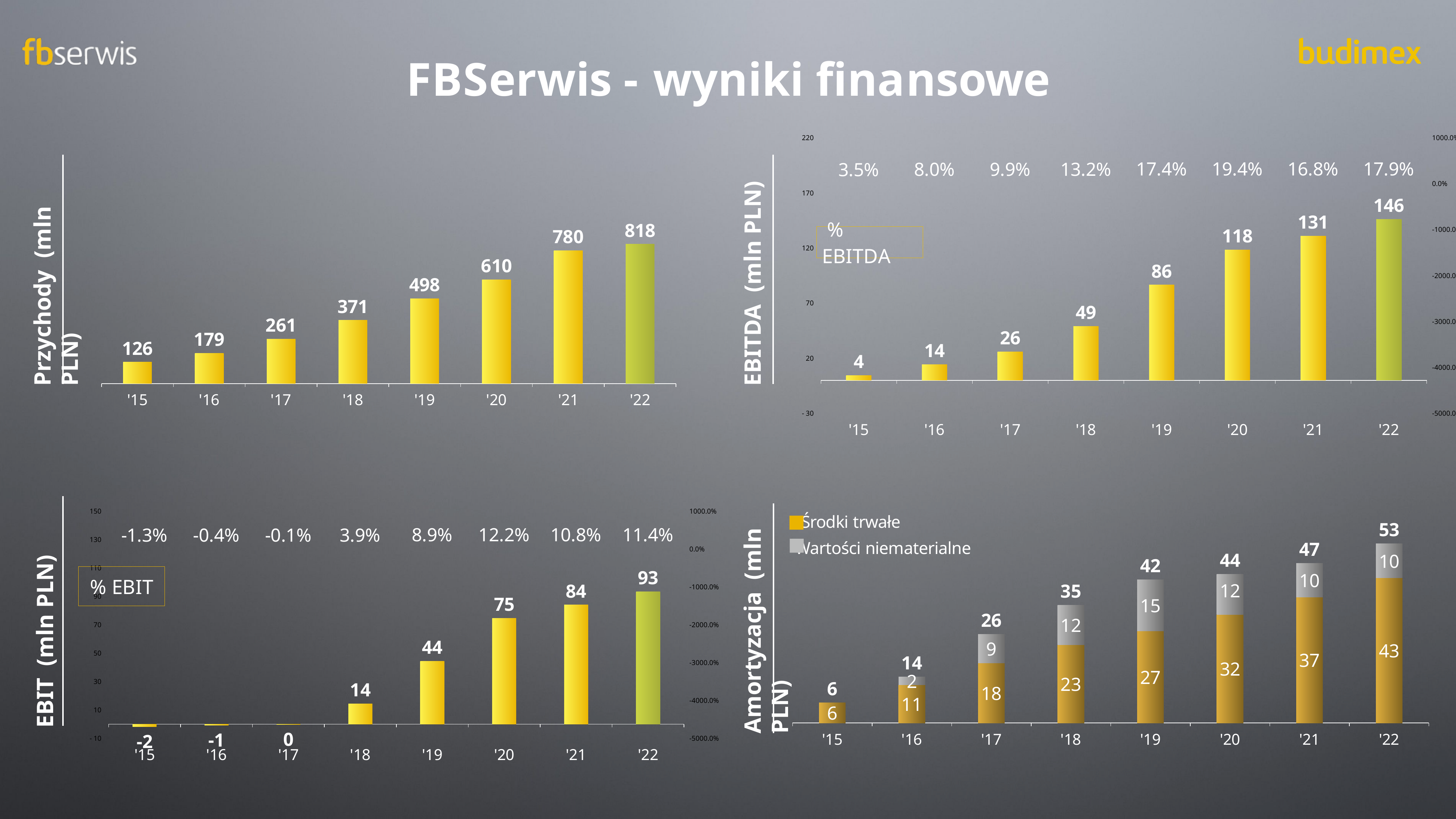
In the EBIT (mln PLN) chart at the bottom left, what is the value for '19? 44 In the EBITDA (mln PLN) chart at the top right, what % EBITDA is shown for '20? 19.4% In the Przychody (mln PLN) chart at the top left, which year has the lowest value? '15 In the Amortyzacja (mln PLN) chart at the bottom right, what is the Środki trwałe value for '21? 37 In the EBIT (mln PLN) chart at the bottom left, how many years are shown on the x axis? 8 In the Amortyzacja (mln PLN) chart at the bottom right, how many series does the legend list? 2 In the EBITDA (mln PLN) chart at the top right, what is the value for '19? 86 In the Przychody (mln PLN) chart at the top left, what is the difference between the values for '21 and '20? 170 In the Przychody (mln PLN) chart at the top left, what is the value for '22? 818 In the EBIT (mln PLN) chart at the bottom left, what % EBIT is shown for '15? -1.3% In the EBITDA (mln PLN) chart at the top right, which year has the highest value? '22 In the Amortyzacja (mln PLN) chart at the bottom right, what is the total of the stacked bar for '19? 42